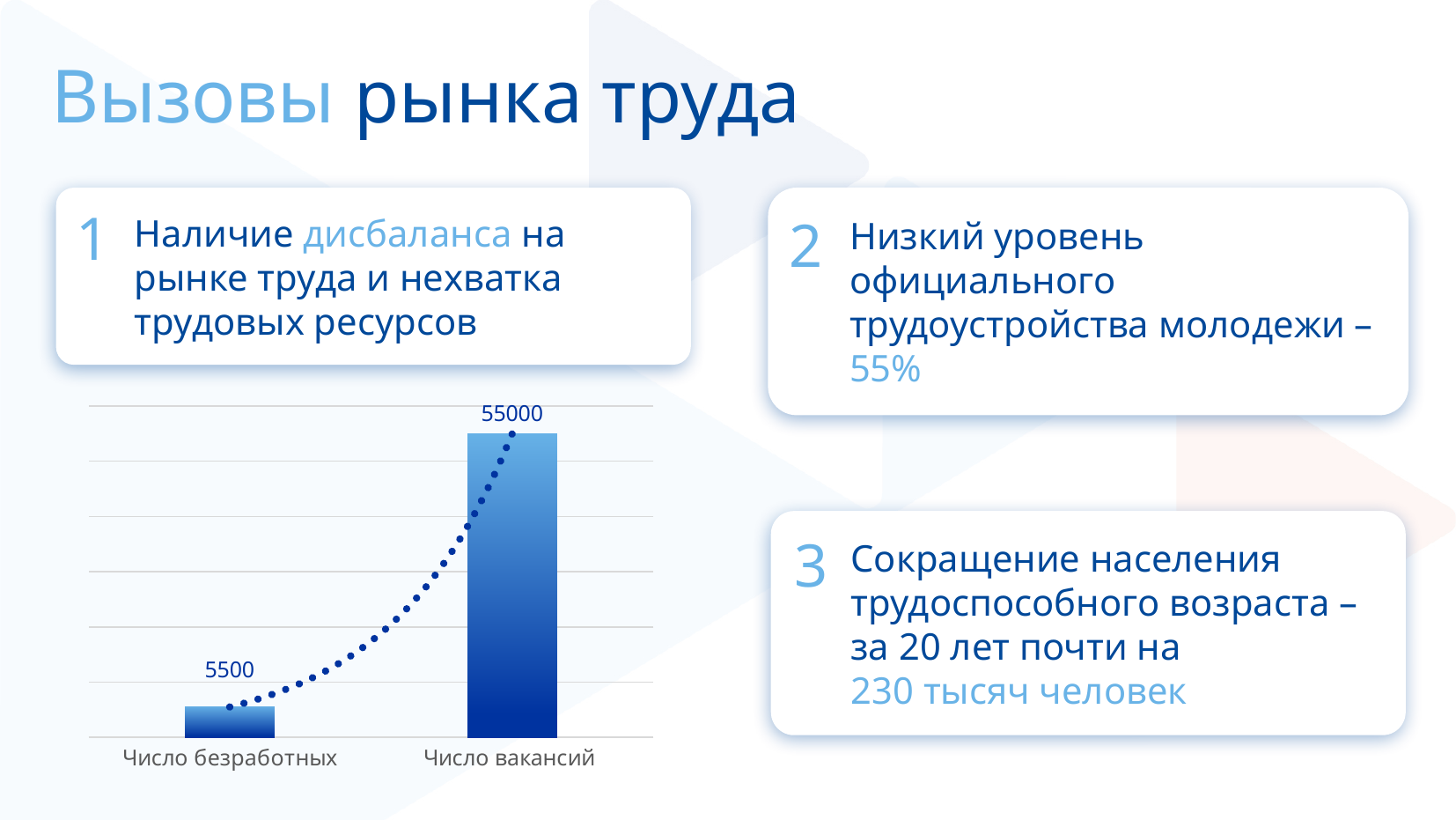
Which category has the highest value in the chart? Число вакансий How many categories are shown in the chart? 2 Which category has the lowest value in the chart? Число безработных Do the values rise or fall from left to right along the x axis of the chart? Rise Besides the bars, what other element is drawn across the chart? A dotted line What is the value for "Число вакансий" in the chart? 55000 What kind of chart is shown on the slide? Bar chart What is the value for "Число безработных" in the chart? 5500 What is the difference between the values for "Число вакансий" and "Число безработных"? 49500 What is the label of the left-hand category in the chart? Число безработных Which is larger: the value for "Число безработных" or the value for "Число вакансий"? Число вакансий